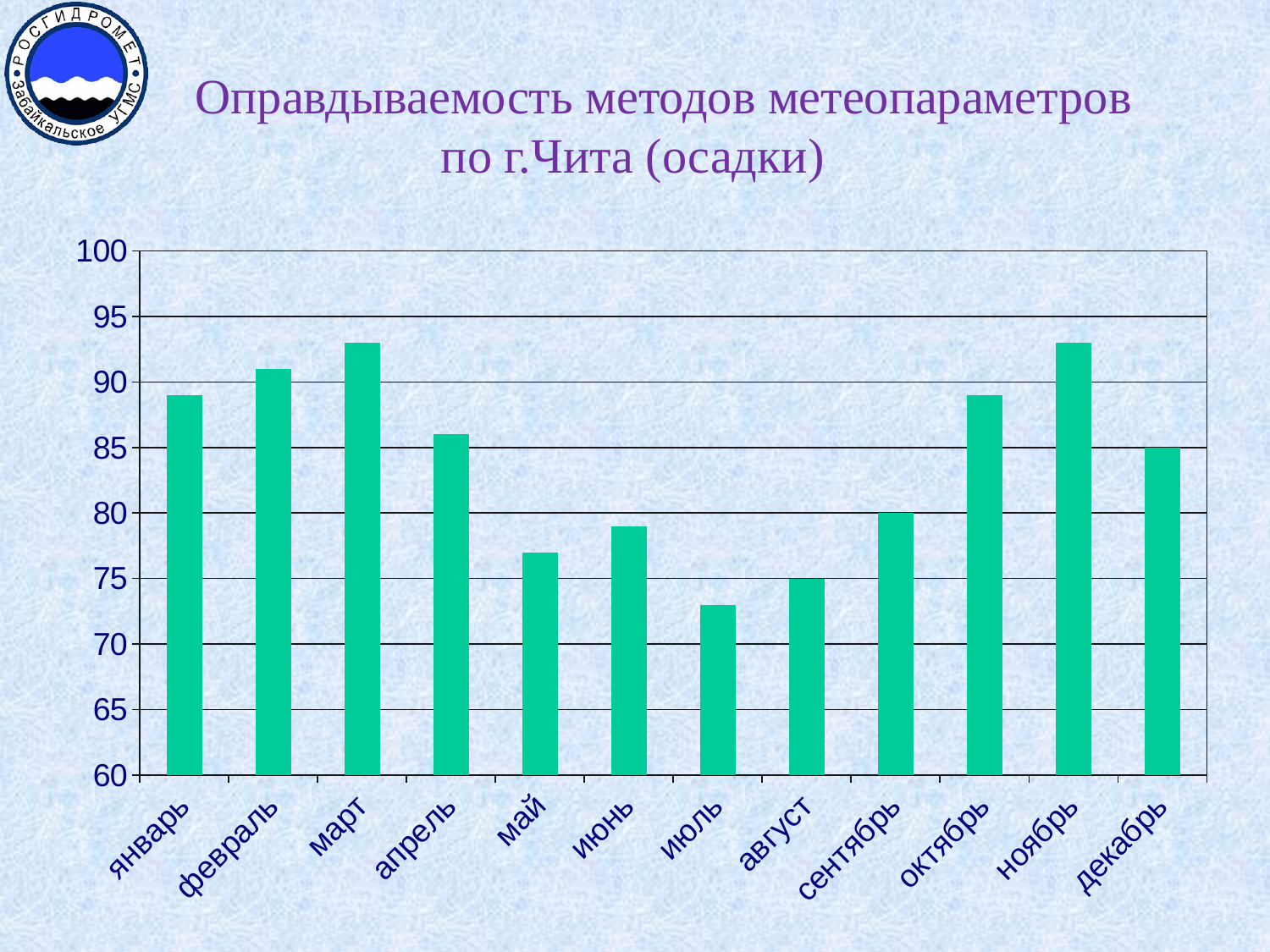
How many months are shown on the x axis of the chart? 12 Is the value for июнь greater or less than 80? less What is the title of the slide? Оправдываемость методов метеопараметров по г.Чита (осадки) Which month has the lowest value? июль Is the value for январь greater or less than 85? greater Is the value for май greater or less than 80? less Which is larger, the value for февраль or the value for май? февраль What is the value for сентябрь? 80 What kind of chart is shown on the slide? bar chart What is the value for декабрь? 85 Do the values rise or fall from март to июль? fall